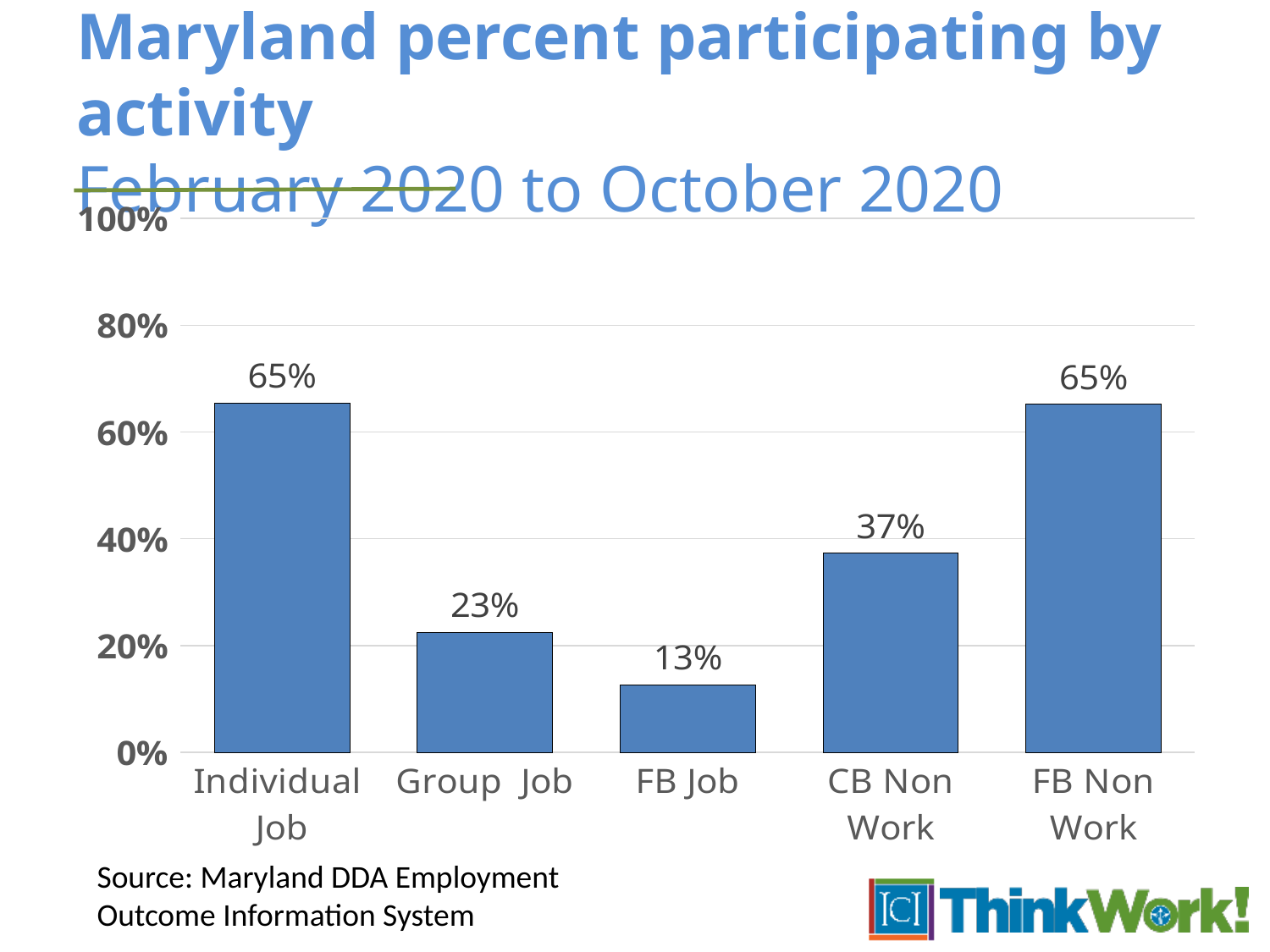
What is the difference between the percent participating for CB Non Work and Group Job? 14% How many activity categories are shown in the chart? 5 Is the value for FB Non Work greater or less than 60%? greater What is the source cited below the chart? Maryland DDA Employment Outcome Information System What is the percent participating for Group Job? 23% What is the percent participating for FB Job? 13% What is the percent participating for Individual Job? 65% What is the percent participating for CB Non Work? 37% Which activity has the lowest percent participating? FB Job Which is larger, the percent participating for CB Non Work or Group Job? CB Non Work What kind of chart is shown on the slide? Bar chart What is the difference between the percent participating for Individual Job and FB Job? 52%